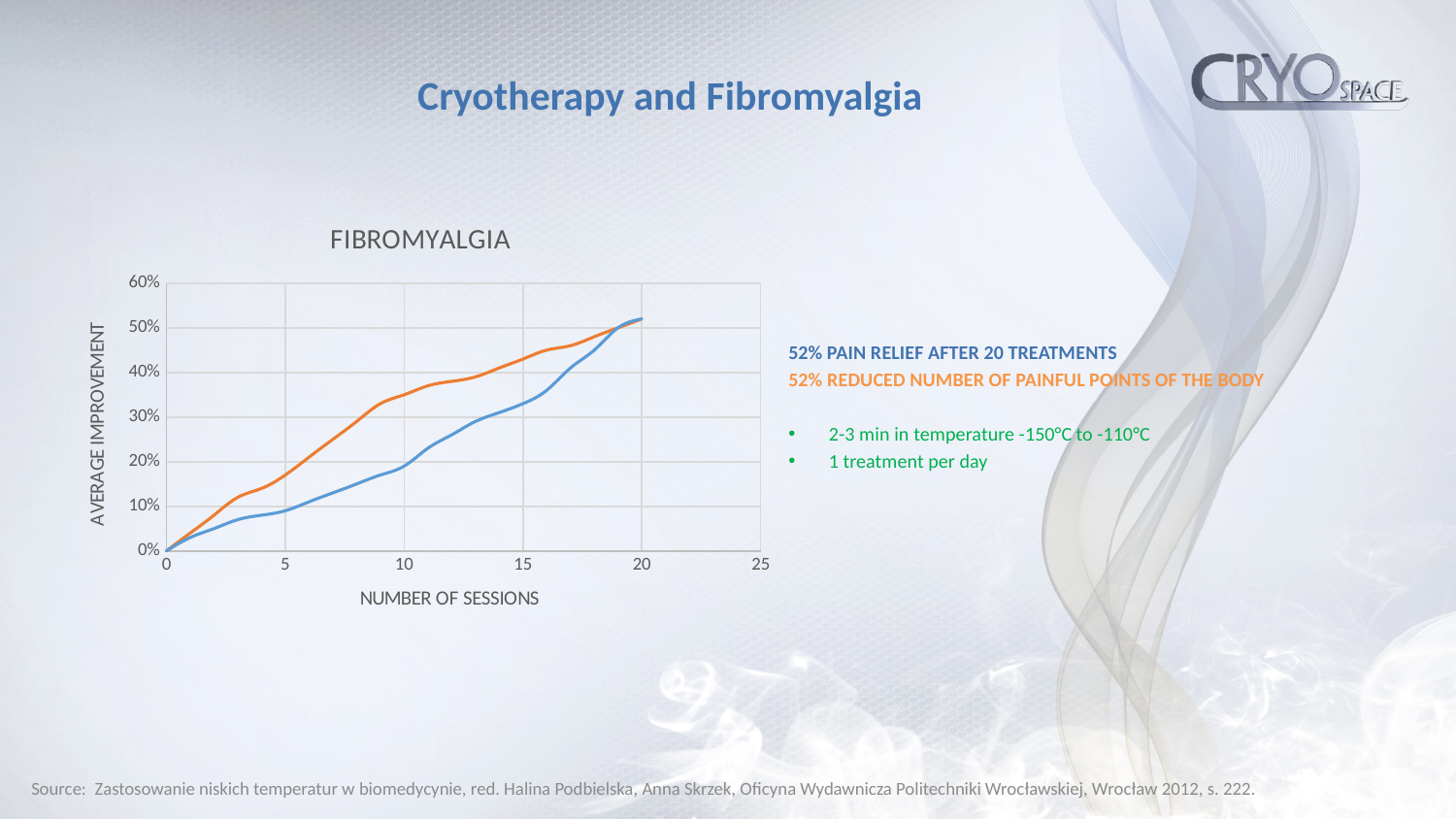
How many lines are plotted on the chart? 2 What is the label of the x axis of the chart? NUMBER OF SESSIONS Is the value of the blue line at 20 sessions greater or less than 50%? greater At 10 sessions, which line shows the higher average improvement, the orange line or the blue line? orange line Is the value of the blue line at 15 sessions greater or less than 40%? less Is the value of the orange line at 15 sessions greater or less than 40%? greater Do the values on the chart rise or fall as the number of sessions increases? rise What is the average improvement for both lines at 0 sessions? 0% What is the title of the chart? FIBROMYALGIA What kind of chart is shown on the slide? line chart